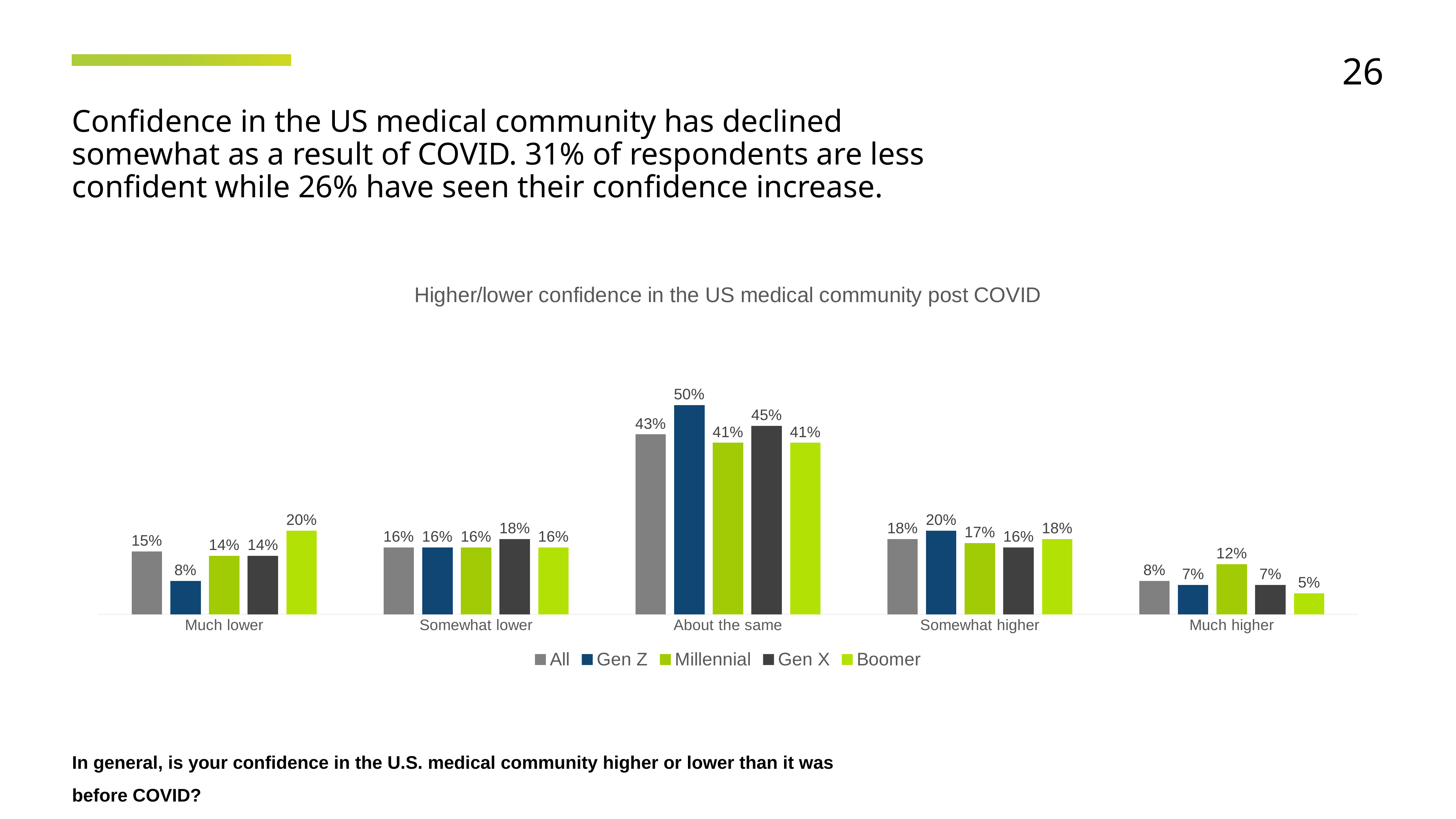
What is the difference between the Boomer and Gen Z values in the "Much lower" category? 12% How many categories are shown on the x axis? 5 Which is larger: the All value for "Somewhat higher" or the All value for "Much higher"? Somewhat higher How many series does the legend list? 5 What is the value for Gen Z in the "About the same" category? 50% What is the value for Boomer in the "Much lower" category? 20% What is the value for Gen X in the "Somewhat lower" category? 18% Which series has the highest value in the "About the same" category? Gen Z What is the difference between the Gen Z and Millennial values in the "About the same" category? 9% What is the value for Millennial in the "Much higher" category? 12% Which series has the lowest value in the "Much higher" category? Boomer What kind of chart is shown on the slide? Bar chart